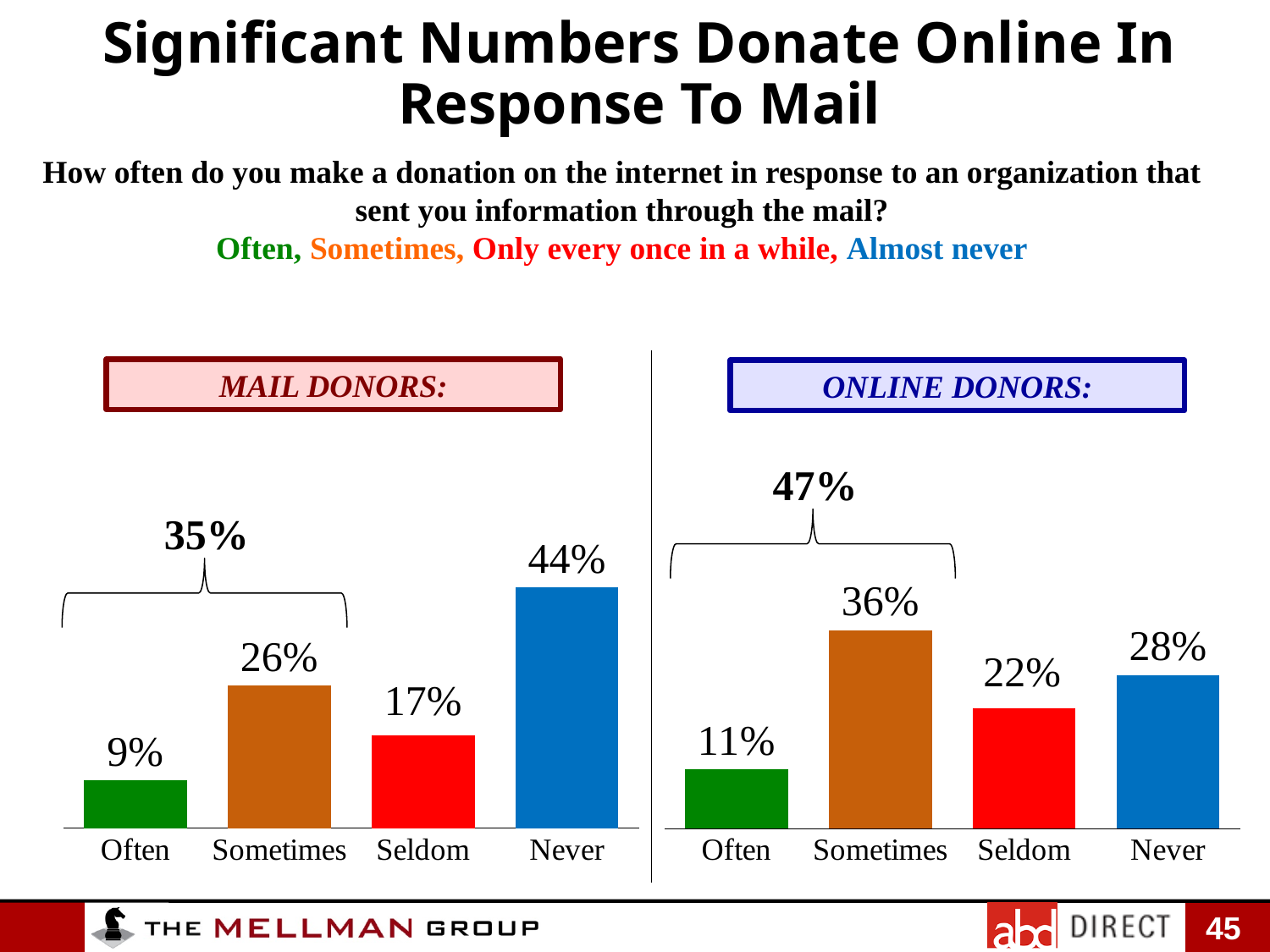
In the Online Donors chart, what combined percentage is shown by the bracket over Often and Sometimes? 47% How many categories are shown in the Online Donors chart? 4 In the Online Donors chart, what percentage is shown for Sometimes? 36% In the Mail Donors chart, what is the difference between Never and Sometimes? 18% In the Mail Donors chart, what percentage is shown for Never? 44% What type of chart is the Mail Donors chart? Bar chart In the Mail Donors chart, what percentage is shown for Often? 9% In the Online Donors chart, what is the difference between Sometimes and Never? 8% In the Online Donors chart, what percentage is shown for Seldom? 22% In the Mail Donors chart, which category has the highest value? Never Which is larger: Seldom in the Mail Donors chart or Seldom in the Online Donors chart? Online Donors In the Online Donors chart, which category has the lowest value? Often